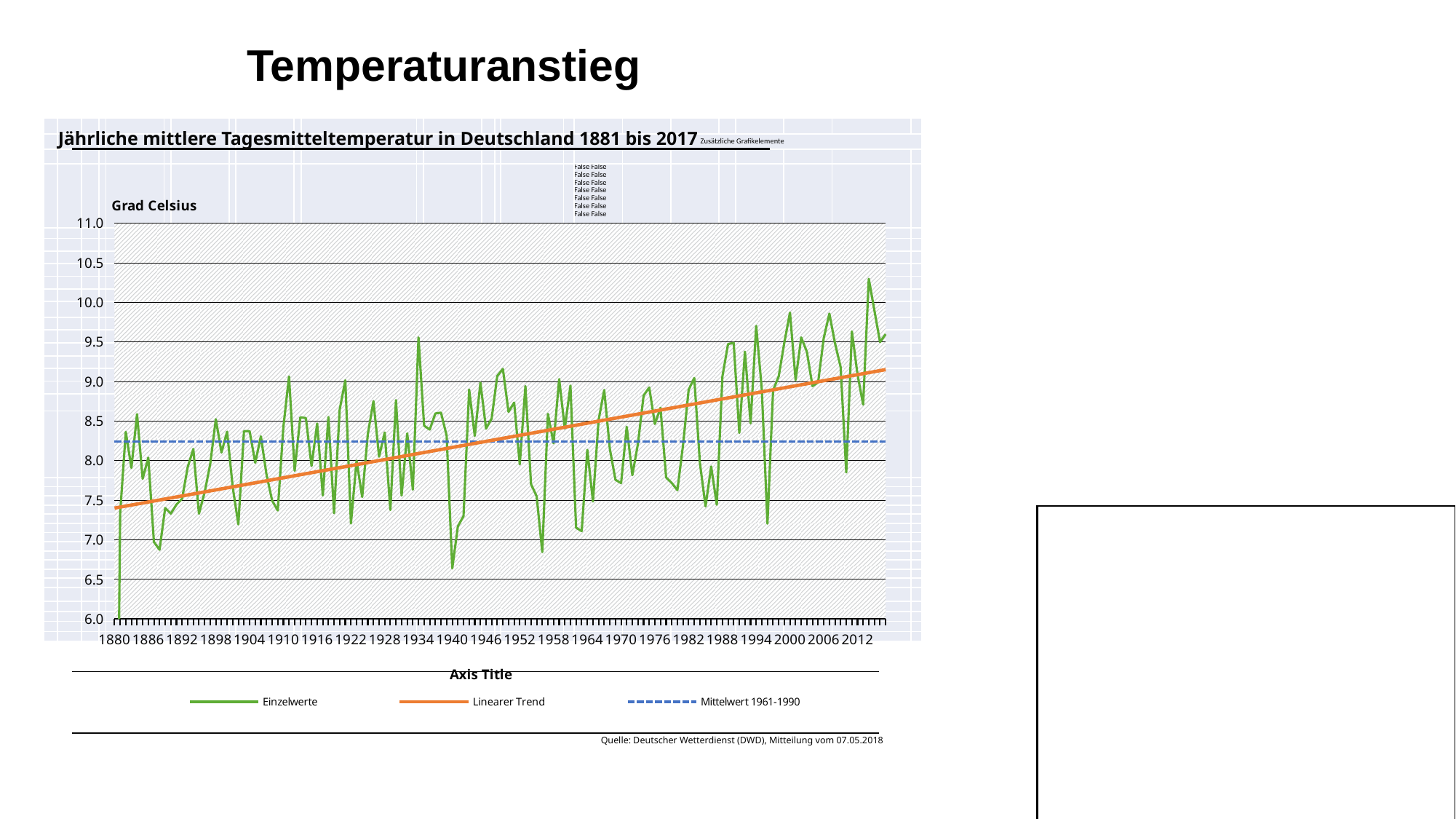
What is the title of the chart? Jährliche mittlere Tagesmitteltemperatur in Deutschland 1881 bis 2017 Which is larger at 2012: the Linearer Trend value or the Mittelwert 1961-1990 value? Linearer Trend Does the Linearer Trend line rise or fall from 1880 to 2012? rise Is the highest Einzelwerte value on the chart greater or less than 10.0? greater How many series does the legend list? 3 What unit is shown as the label of the vertical axis? Grad Celsius Is the Linearer Trend value at 2012 greater or less than 9.0? greater Is the value of the Mittelwert 1961-1990 line greater or less than 8.5? less What kind of chart is shown on the slide? line chart How many year labels are printed on the horizontal axis? 23